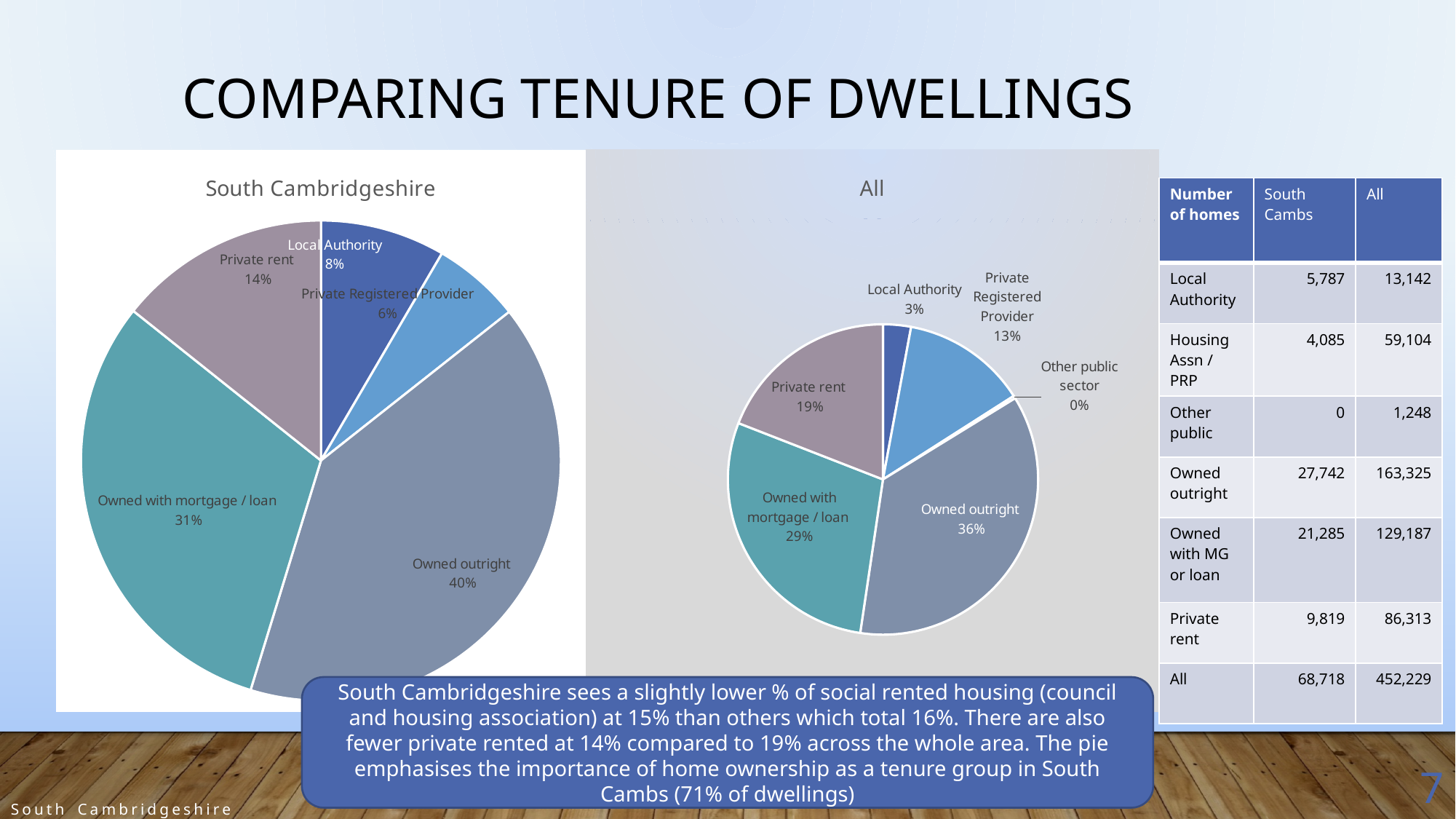
In the South Cambridgeshire pie chart, what is the share for Private Registered Provider? 6% In the All pie chart, what percentage of dwellings are Private rent? 19% In the All pie chart, what is the share for Local Authority? 3% In the South Cambridgeshire pie chart, which tenure category has the largest share? Owned outright How many slices does the All pie chart have? 6 In the South Cambridgeshire pie chart, what percentage of dwellings are Owned outright? 40% What type of chart is used for the South Cambridgeshire data? Pie chart In the South Cambridgeshire pie chart, which tenure category has the smallest share? Private Registered Provider In the All pie chart, which tenure category has the smallest share? Other public sector In the All pie chart, which is larger: Owned with mortgage / loan or Private rent? Owned with mortgage / loan What is the difference between the Owned outright share in the South Cambridgeshire pie chart and the Owned outright share in the All pie chart? 4% How many slices does the South Cambridgeshire pie chart have? 5